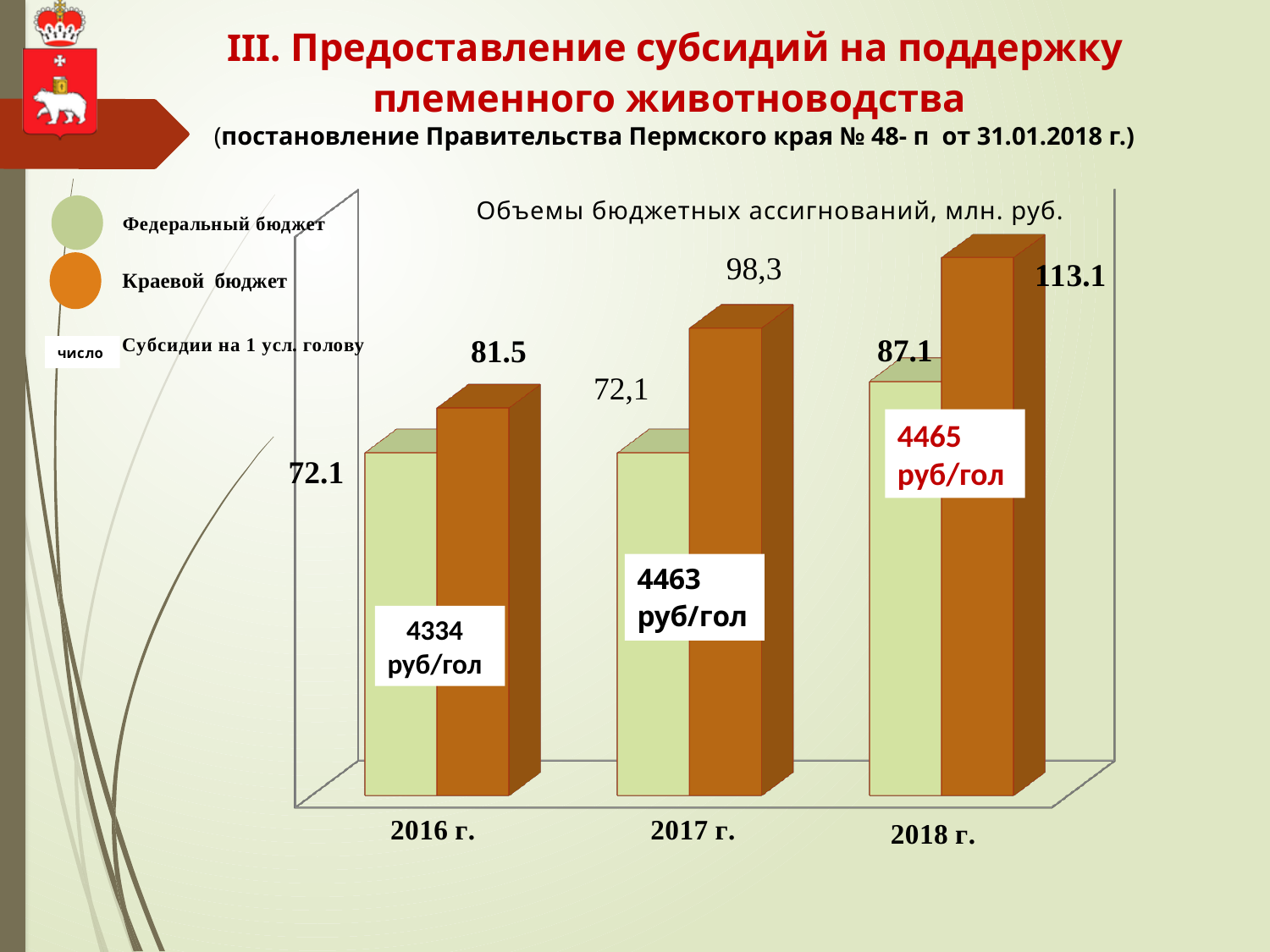
What is the value for Краевой бюджет in 2018 г.? 113.1 Which is larger in 2016 г.: Федеральный бюджет or Краевой бюджет? Краевой бюджет What is the value for Федеральный бюджет in 2018 г.? 87.1 How many years are shown on the x axis of the chart? 3 What is the subsidy per conditional head (Субсидии на 1 усл. голову) shown for 2016 г.? 4334 руб/гол In which year is the Краевой бюджет value highest? 2018 г. What type of chart is shown on the slide? bar chart What is the difference between the Краевой бюджет and Федеральный бюджет values in 2018 г.? 26.0 What is the subsidy per conditional head shown for 2018 г.? 4465 руб/гол What is the value for Краевой бюджет in 2017 г.? 98,3 Does the Краевой бюджет value rise or fall from 2016 г. to 2018 г.? rise What is the value for Федеральный бюджет in 2016 г.? 72.1